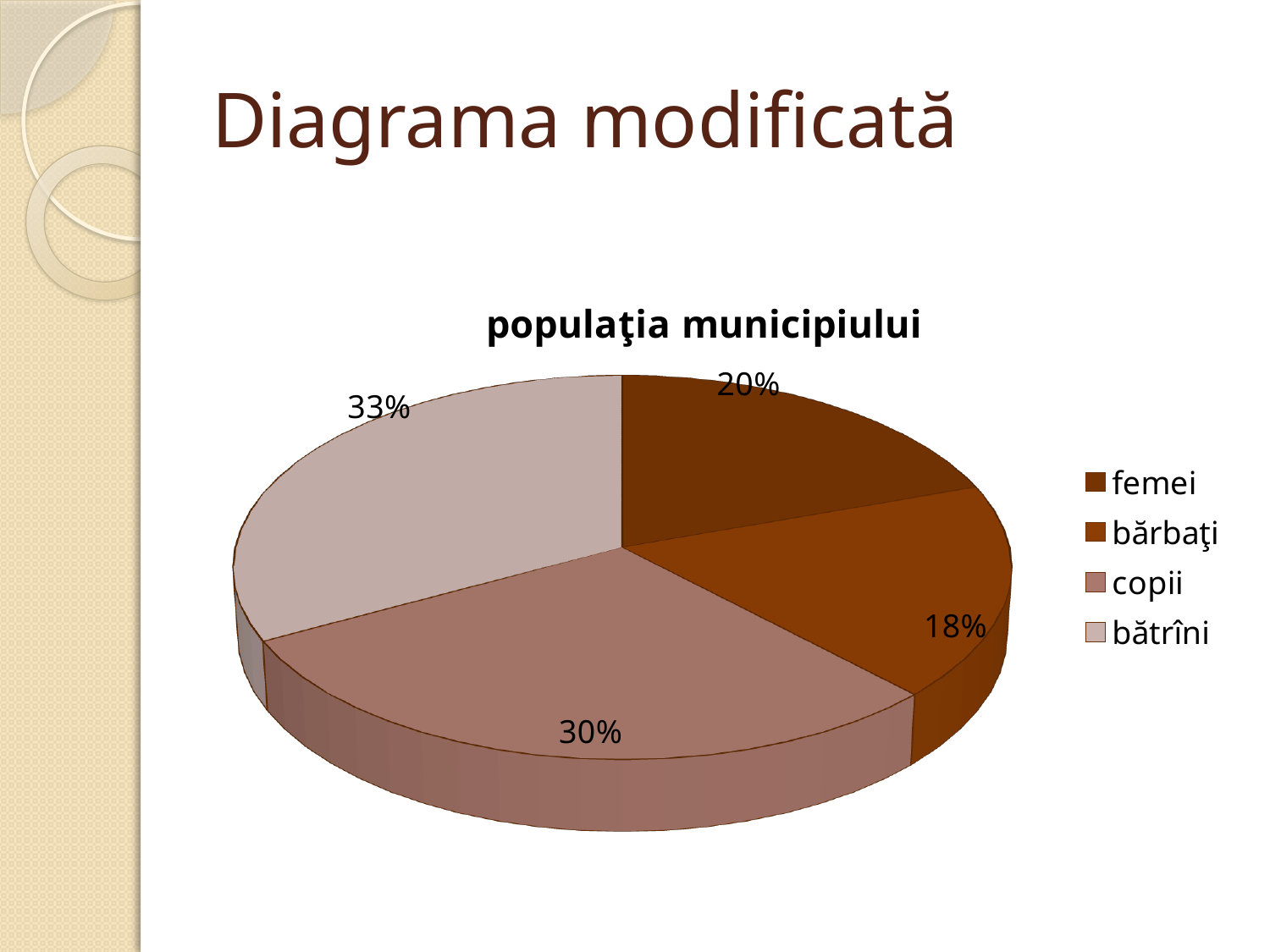
How many slices does the pie chart have? 4 What percentage of the pie is the copii slice? 30% How many entries does the legend list? 4 Which category has the smallest share of the pie? bărbaţi What is the difference in percentage points between the copii slice and the femei slice? 10 Which slice is larger, copii or bărbaţi? copii What is the chart's title? populaţia municipiului What type of chart is shown on the slide? pie chart What percentage of the pie is the femei slice? 20% What percentage of the pie is the bătrîni slice? 33% Which category has the largest share of the pie? bătrîni What percentage of the pie is the bărbaţi slice? 18%